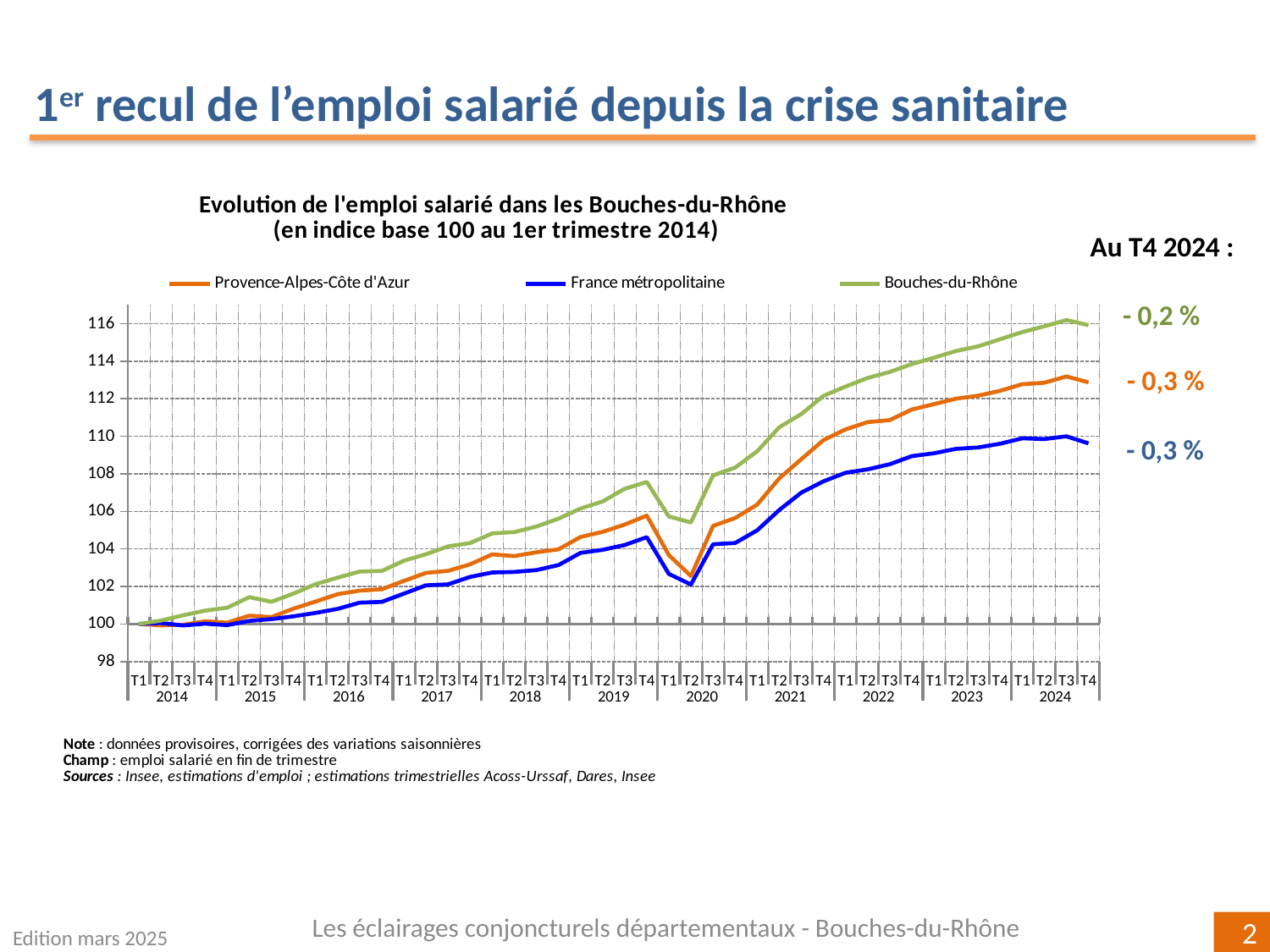
At T2 2020, which is larger: Bouches-du-Rhône or France métropolitaine? Bouches-du-Rhône Which series has the highest value at T4 2024? Bouches-du-Rhône Is the value for Bouches-du-Rhône at T4 2024 greater or less than 114? greater How many series does the legend list? 3 Which series is plotted in blue? France métropolitaine Is the value for Provence-Alpes-Côte d'Azur at T4 2024 greater or less than 112? greater Overall, do the values rise or fall from 2014 to 2024? rise Is the value for France métropolitaine at T4 2024 greater or less than 110? less What kind of chart is shown on the slide? line chart Which series has the lowest value at T4 2024? France métropolitaine What is the base value of the index at T1 2014, according to the chart title? 100 How many years are shown on the x axis? 11